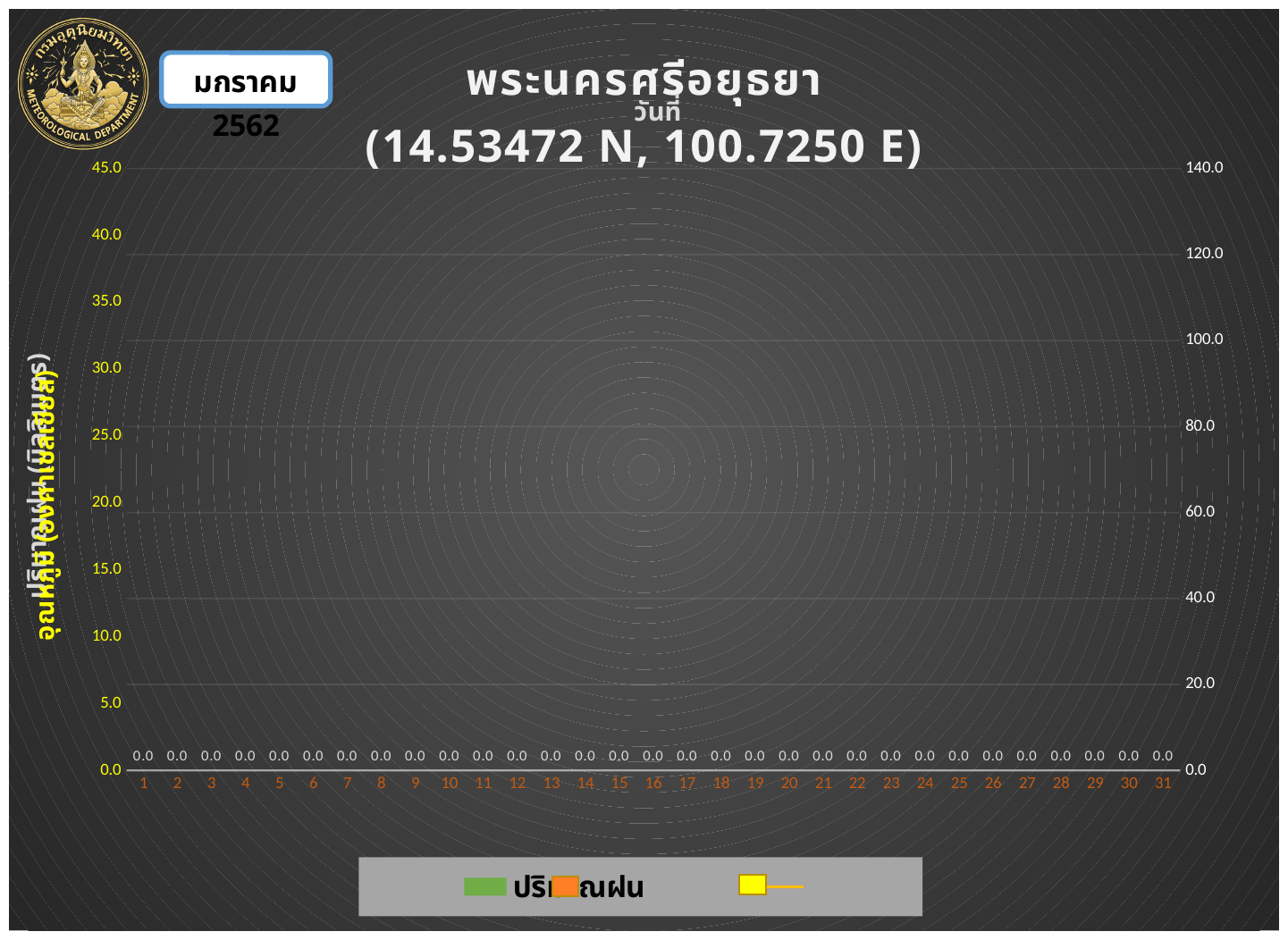
What value is labelled for day 1 on the chart? 0.0 What value is labelled for day 15 on the chart? 0.0 What is the highest tick value shown on the left vertical axis of the chart? 45.0 What value is labelled for day 31 on the chart? 0.0 What value is labelled for day 22 on the chart? 0.0 What is the highest tick value shown on the right vertical axis of the chart? 140.0 What coordinates are given in the chart title? 14.53472 N, 100.7250 E How many days (categories) are shown along the x axis of the chart? 31 Is the value for day 10 greater or less than 20.0? less What is the difference between the values labelled for day 5 and day 20? 0.0 Is the value for day 28 greater or less than 5.0? less